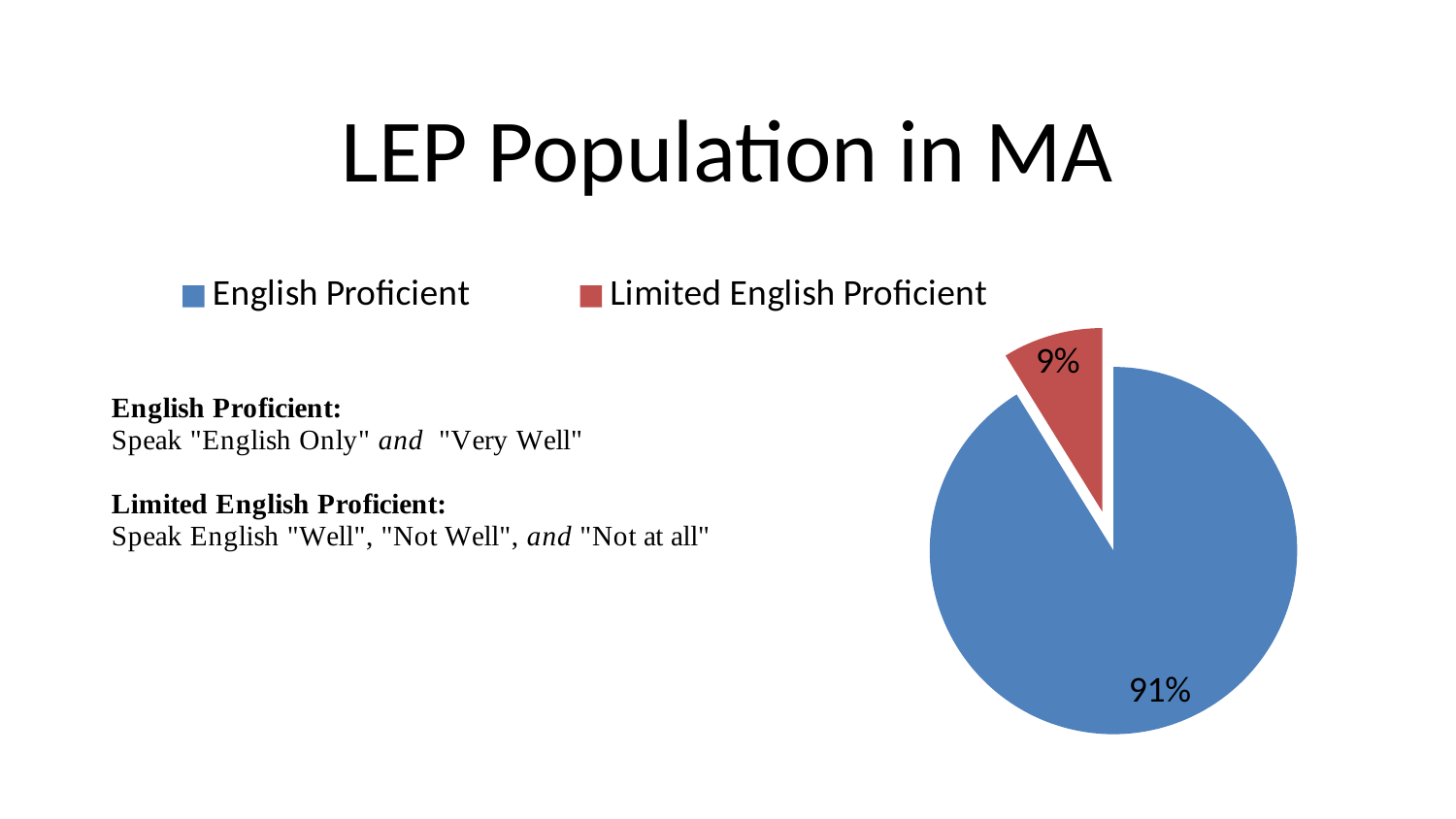
What share of the pie is labelled Limited English Proficient? 9% What colour is the Limited English Proficient slice? red What is the title of the slide containing the pie chart? LEP Population in MA Which slice of the pie is the smallest? Limited English Proficient Which slice of the pie is the largest? English Proficient How many slices does the pie chart have? 2 What kind of chart is shown on the slide? pie chart What share of the pie is labelled English Proficient? 91% How many entries does the legend list? 2 What is the difference in percentage points between the English Proficient and Limited English Proficient slices? 82 Which is larger, the English Proficient slice or the Limited English Proficient slice? English Proficient